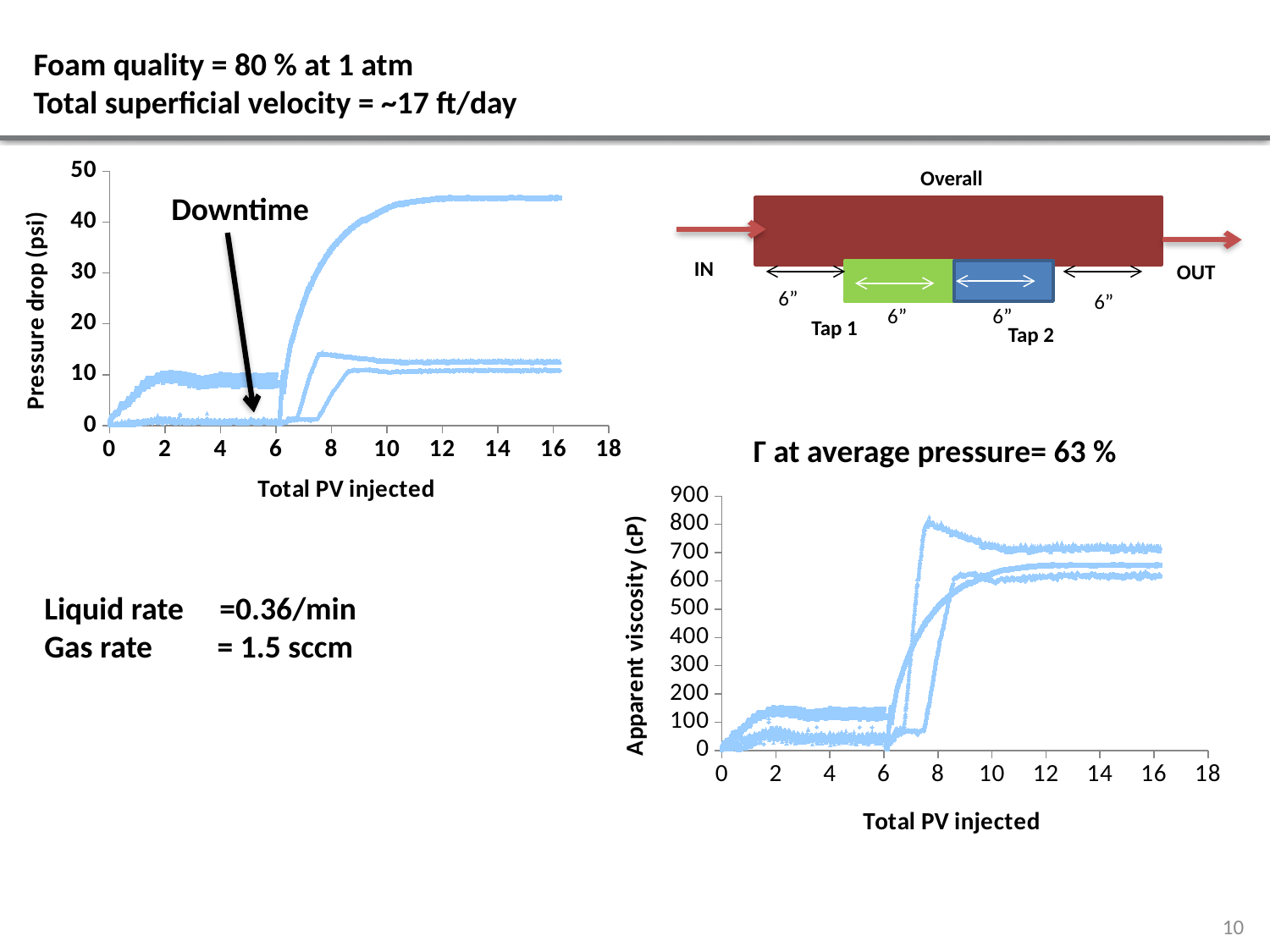
In the pressure drop chart, at roughly what total PV injected does the 'Downtime' arrow point: before or after 6? before What is the y-axis title of the chart on the bottom right of the slide? Apparent viscosity (cP) In the pressure drop chart, is the value of the highest curve at 4 total PV injected greater or less than 20? less What is the highest tick value on the x axis of the apparent viscosity chart? 18 What kind of chart is the pressure drop chart on the left of the slide? line chart In the pressure drop chart, do the curves overall rise or fall as total PV injected increases? rise In the apparent viscosity chart, is the value of the highest curve at 14 total PV injected greater or less than 600? greater In the apparent viscosity chart, do the curves overall rise or fall as total PV injected increases? rise What is the y-axis title of the chart on the left of the slide? Pressure drop (psi) How many curves are plotted in the pressure drop chart? 3